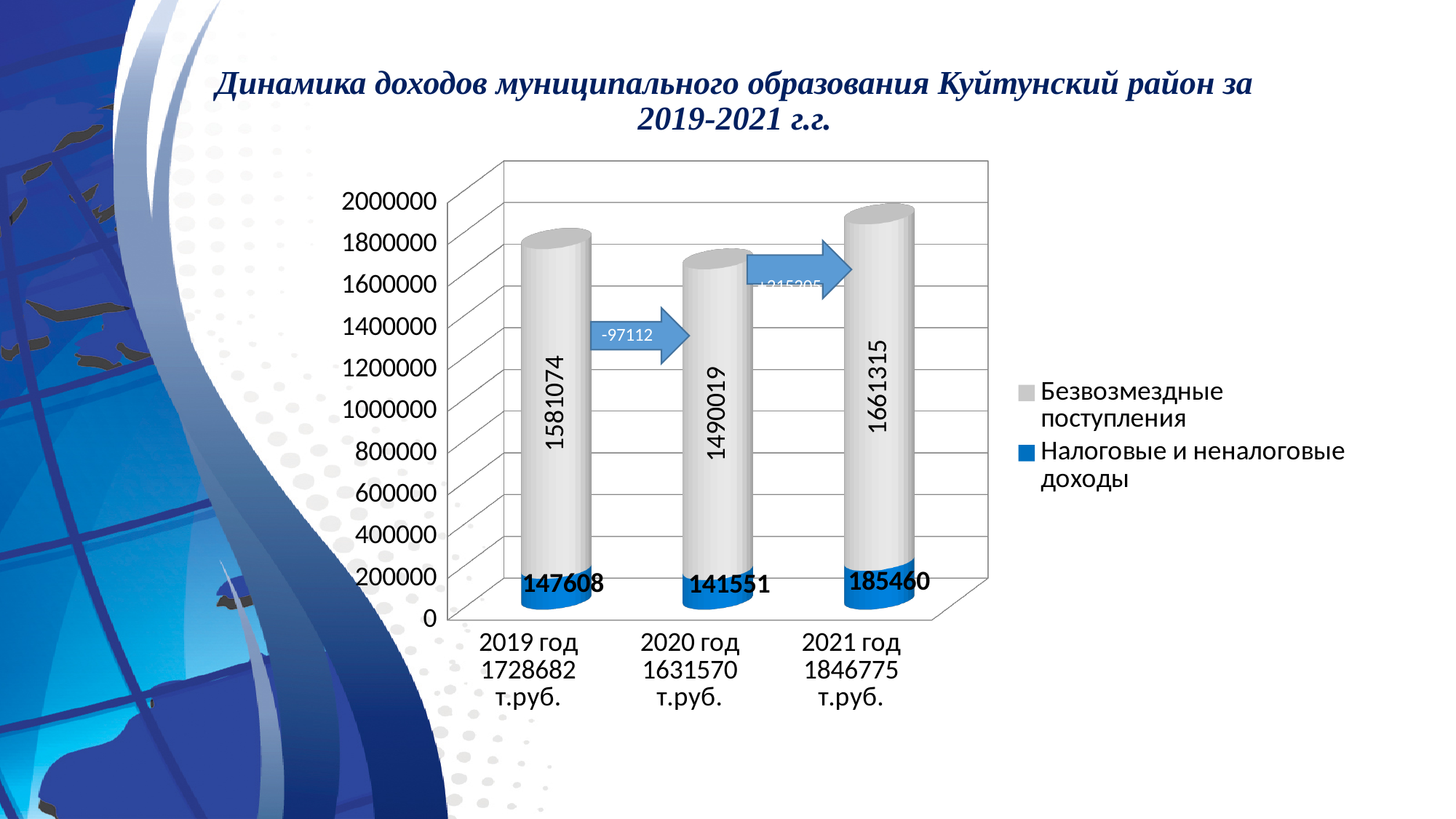
Which year has the lowest value of Налоговые и неналоговые доходы? 2020 год How many series does the legend list? 2 How many years (categories) are plotted on the chart? 3 What type of chart is shown on the slide? bar chart What is the total of the stacked bar for 2021 год? 1846775 What is the value of Безвозмездные поступления for 2020 год? 1490019 What is the value of Безвозмездные поступления for 2019 год? 1581074 Which series is shown in blue in the legend? Налоговые и неналоговые доходы What is the difference between Безвозмездные поступления in 2021 год and 2020 год? 171296 Which year has the highest value of Безвозмездные поступления? 2021 год What is the value of Налоговые и неналоговые доходы for 2021 год? 185460 Which is larger: Налоговые и неналоговые доходы in 2019 год or in 2020 год? 2019 год